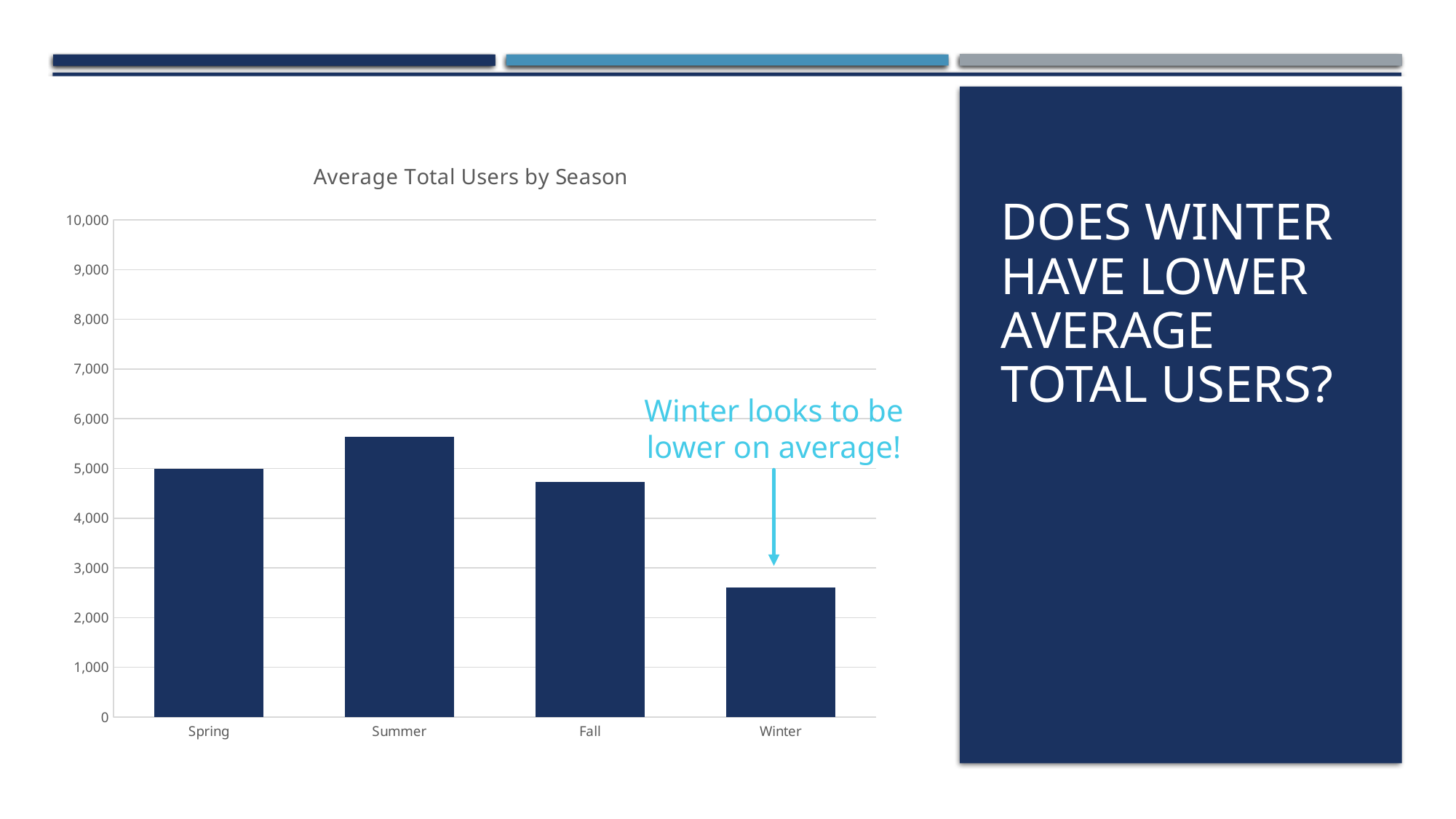
Which season has the lowest average total users? Winter How many seasons are plotted in the chart? 4 What is the title of the chart? Average Total Users by Season Is the value for Summer greater or less than 5,000? greater Is the value for Winter greater or less than 2,000? greater Which season has the highest average total users? Summer Is the value for Winter greater or less than 3,000? less What does the annotation with the arrow pointing to the Winter bar say? Winter looks to be lower on average! Which has more average total users, Summer or Winter? Summer What type of chart is shown on the slide? bar chart